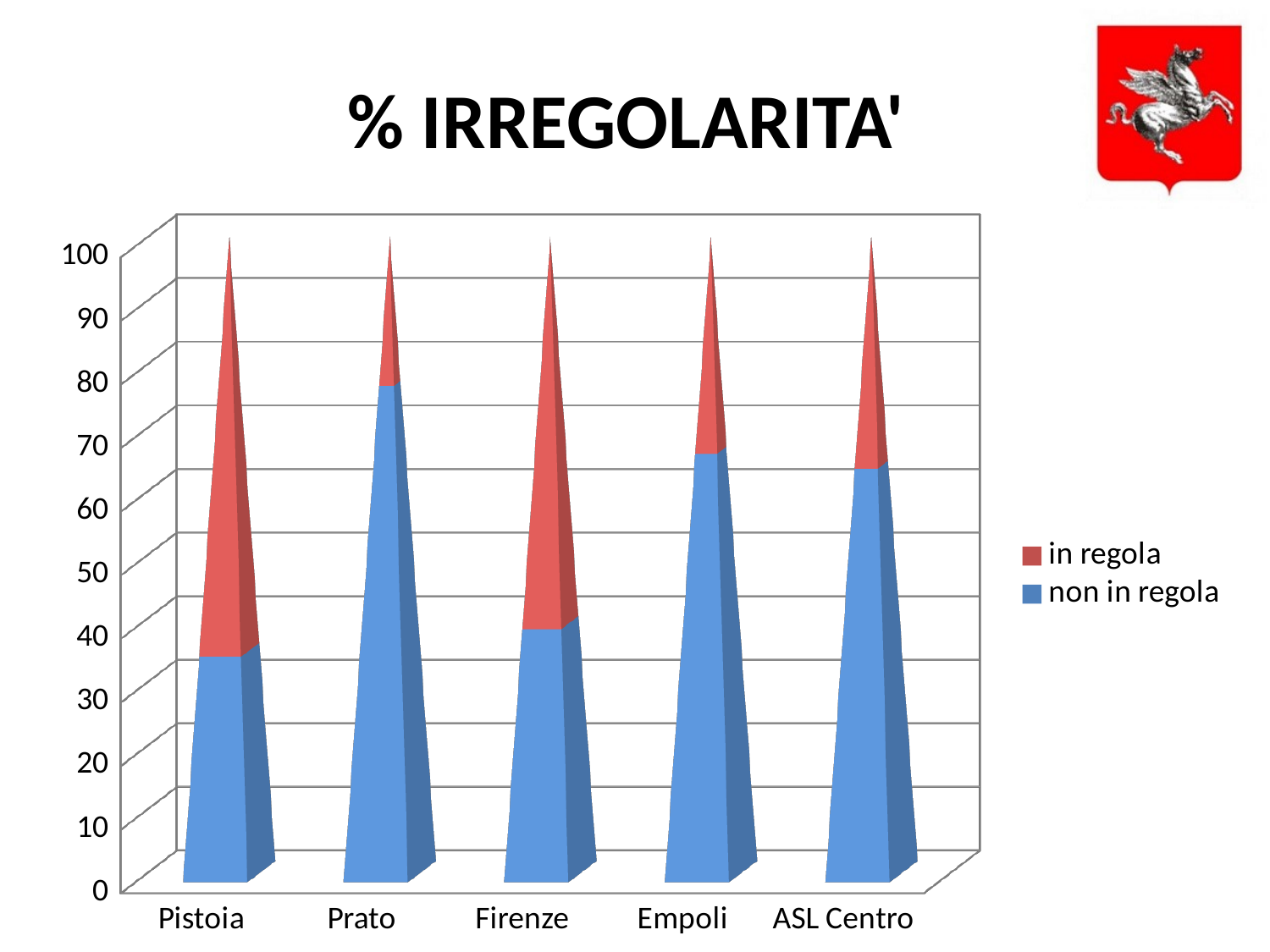
Is the 'non in regola' value for Empoli greater or less than 60? greater Is the 'non in regola' value for Prato greater or less than 70? greater Is the 'non in regola' value for Pistoia greater or less than 50? less What is the title of the chart? % IRREGOLARITA' Which category has the highest 'non in regola' value? Prato What kind of chart is shown on the slide? bar chart Which colour represents the 'non in regola' series in the chart? blue How many series does the legend list? 2 How many categories are shown on the x axis of the chart? 5 Which category has the highest 'in regola' value? Pistoia Which has a larger 'non in regola' value, Prato or Firenze? Prato